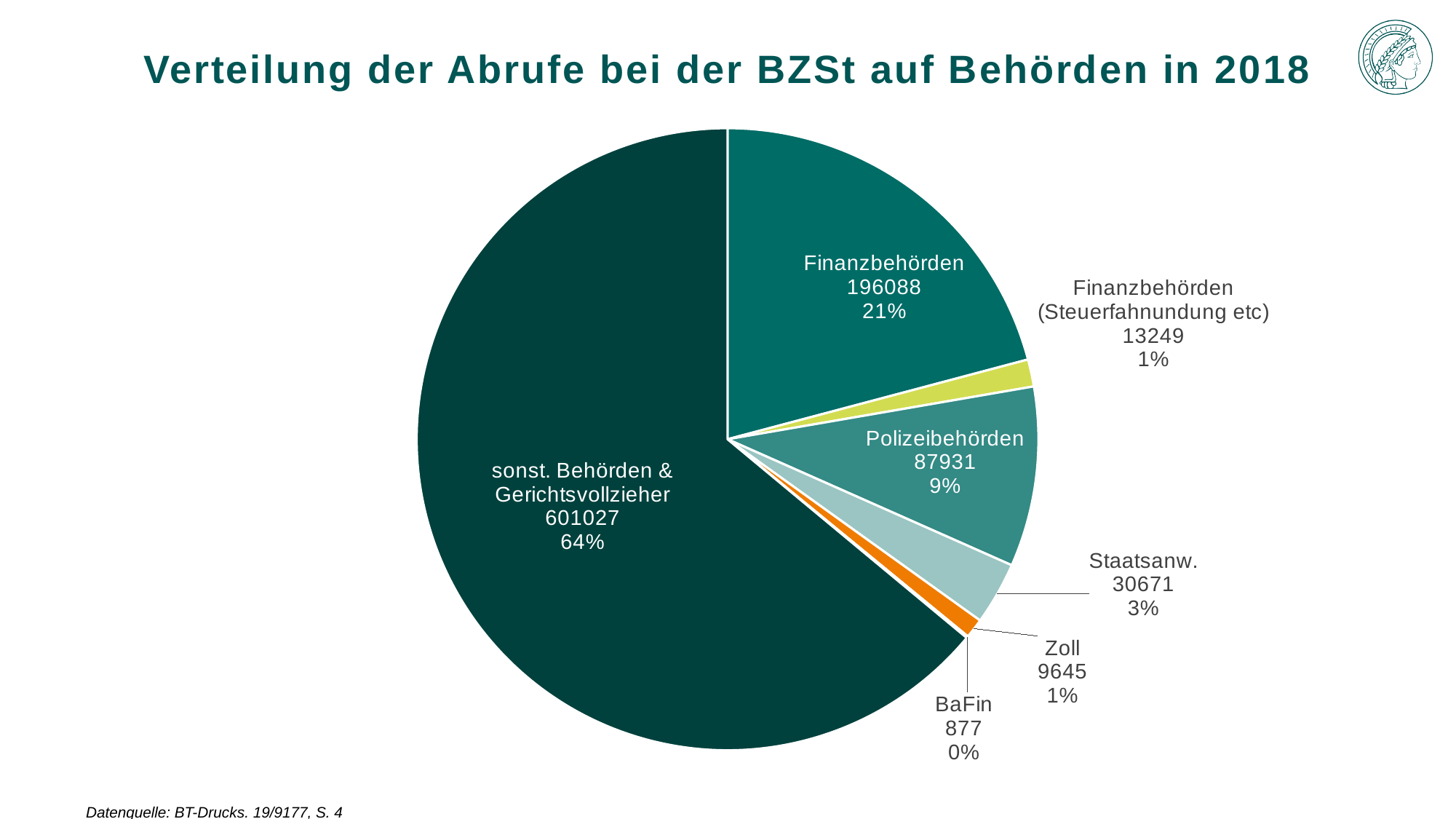
Which category has the largest slice? sonst. Behörden & Gerichtsvollzieher What is the value for Finanzbehörden? 196088 What is the value for Polizeibehörden? 87931 Which is larger, the value for Staatsanw. or the value for Finanzbehörden (Steuerfahnundung etc)? Staatsanw. How many slices does the pie chart have? 7 Which category has the smallest slice? BaFin What share of the pie does Finanzbehörden represent? 21% What kind of chart is shown on the slide? pie chart What is the value for Staatsanw.? 30671 What share of the pie does sonst. Behörden & Gerichtsvollzieher represent? 64% What is the difference between the values for Finanzbehörden and Polizeibehörden? 108157 What is the value for Zoll? 9645